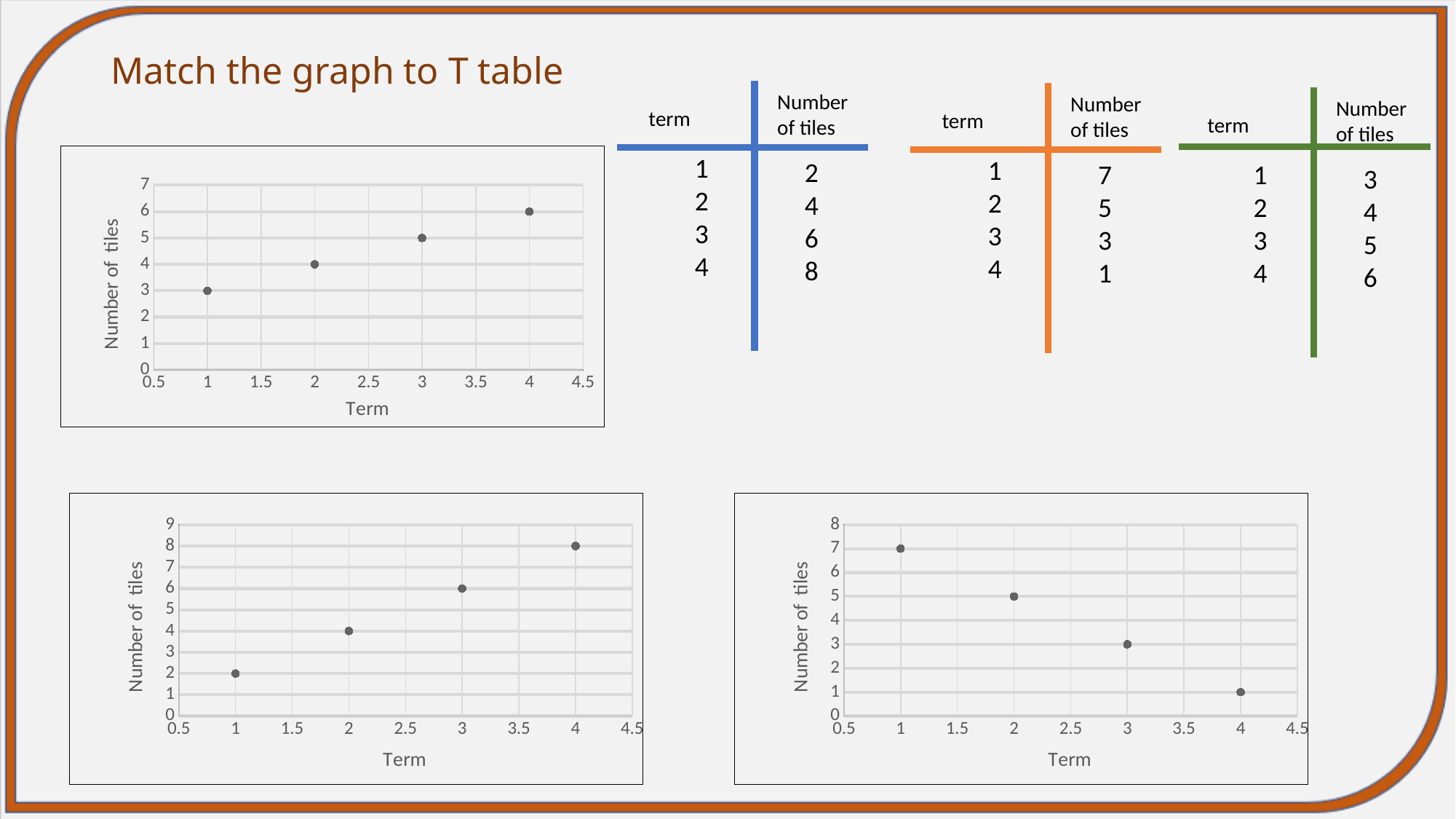
In the top-left chart, what is the number of tiles at term 1? 3 In the top-left chart, do the values rise or fall as the term increases? rise What kind of chart is the top-left chart? scatter chart In the bottom-right chart, is the number of tiles at term 2 larger or smaller than at term 3? larger In the bottom-left chart, what is the number of tiles at term 3? 6 In the bottom-right chart, what is the number of tiles at term 1? 7 In the bottom-left chart, what is the difference in number of tiles between term 4 and term 1? 6 How many data points are plotted in the bottom-right chart? 4 In the bottom-right chart, do the values rise or fall as the term increases? fall In the bottom-left chart, which term has the highest number of tiles? 4 In the bottom-right chart, which term has the lowest number of tiles? 4 In the top-left chart, what is the number of tiles at term 4? 6